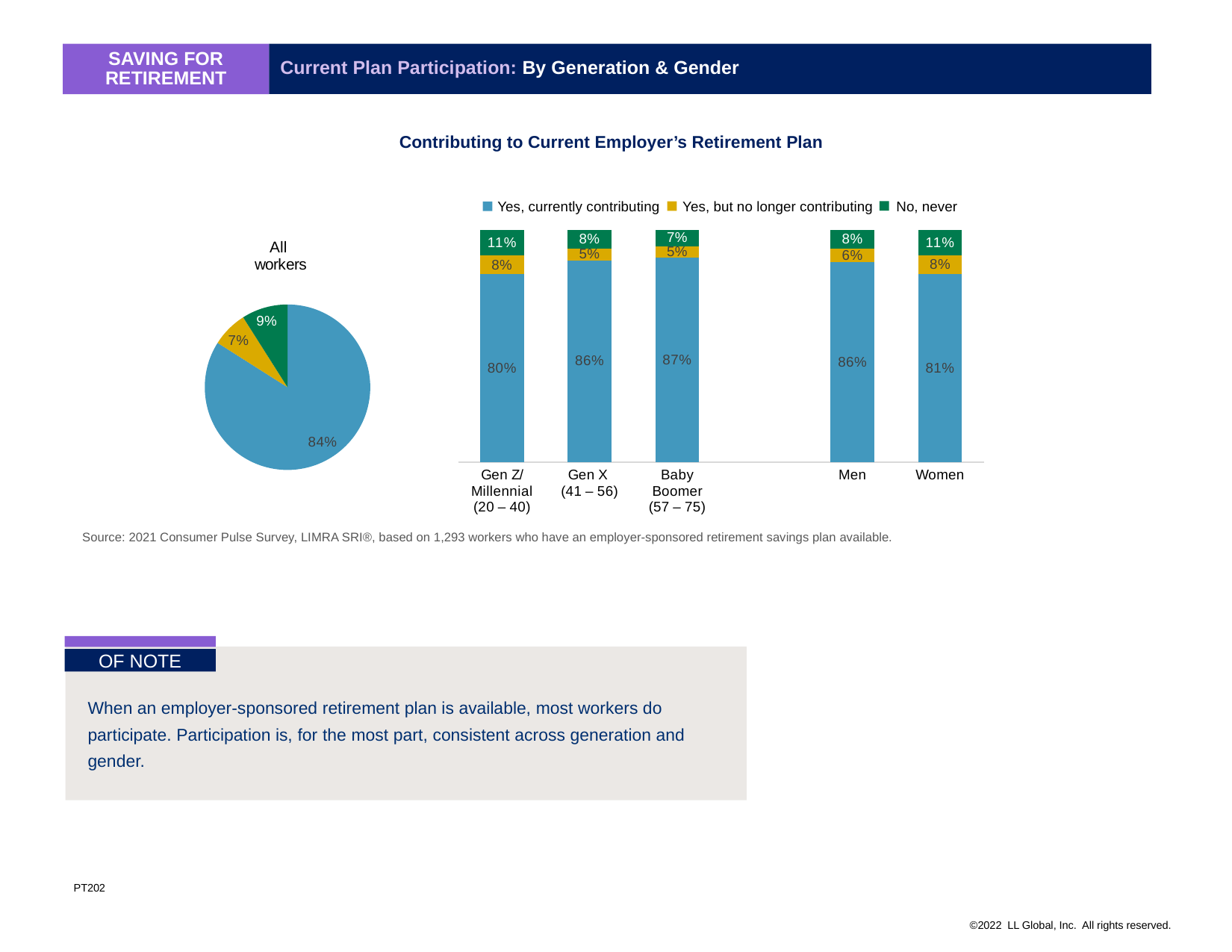
In the pie chart for All workers, what share of workers answered 'No, never'? 9% In the bar chart on the right, which group has the lowest 'Yes, currently contributing' value? Gen Z/Millennial (20 – 40) In the bar chart on the right, which group has the highest 'Yes, currently contributing' value? Baby Boomer (57 – 75) In the bar chart on the right, what is the 'Yes, currently contributing' value for Baby Boomer (57 – 75)? 87% How many series does the legend of the bar chart on the right list? 3 In the bar chart on the right, what is the 'No, never' value for Women? 11% How many groups are shown along the x axis of the bar chart on the right? 5 What kind of chart is the 'All workers' chart on the left? Pie chart In the bar chart on the right, what is the difference in 'Yes, currently contributing' between Men and Women? 5 percentage points In the bar chart on the right, what is the 'Yes, but no longer contributing' value for Men? 6% In the bar chart on the right, which has the larger 'No, never' value, Gen X (41 – 56) or Women? Women In the pie chart for All workers, what share of workers are 'Yes, currently contributing'? 84%